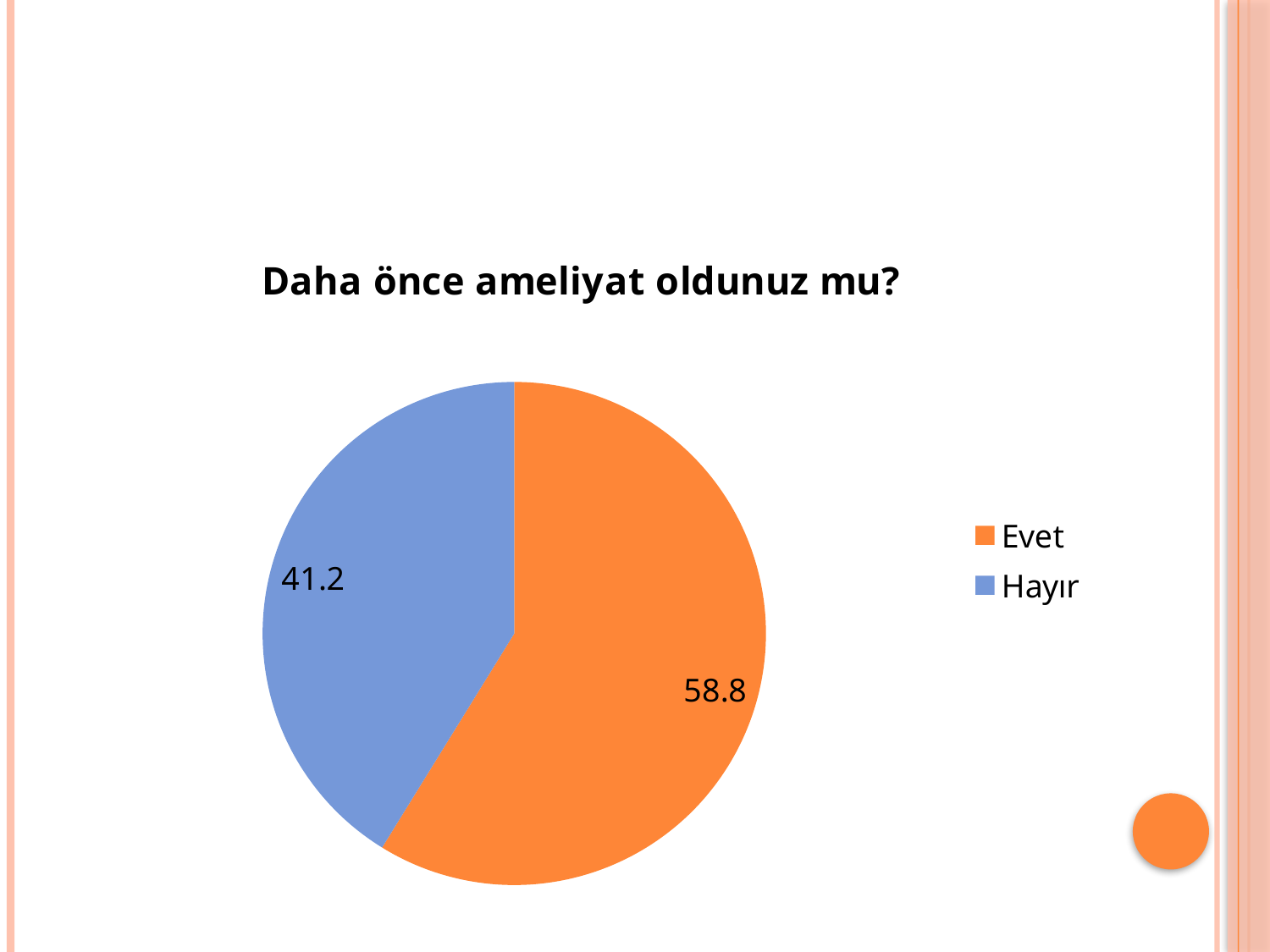
What is the total of the two slice values? 100 What is the value for Evet? 58.8 What is the title of the chart? Daha önce ameliyat oldunuz mu? Which category has the smallest slice? Hayır What is the value for Hayır? 41.2 What is the difference between the values for Evet and Hayır? 17.6 How many entries does the legend list? 2 How many slices does the pie chart have? 2 What kind of chart is shown on the slide? pie chart Which is larger, Evet or Hayır? Evet Which category has the largest slice? Evet What colour is the Hayır slice? blue